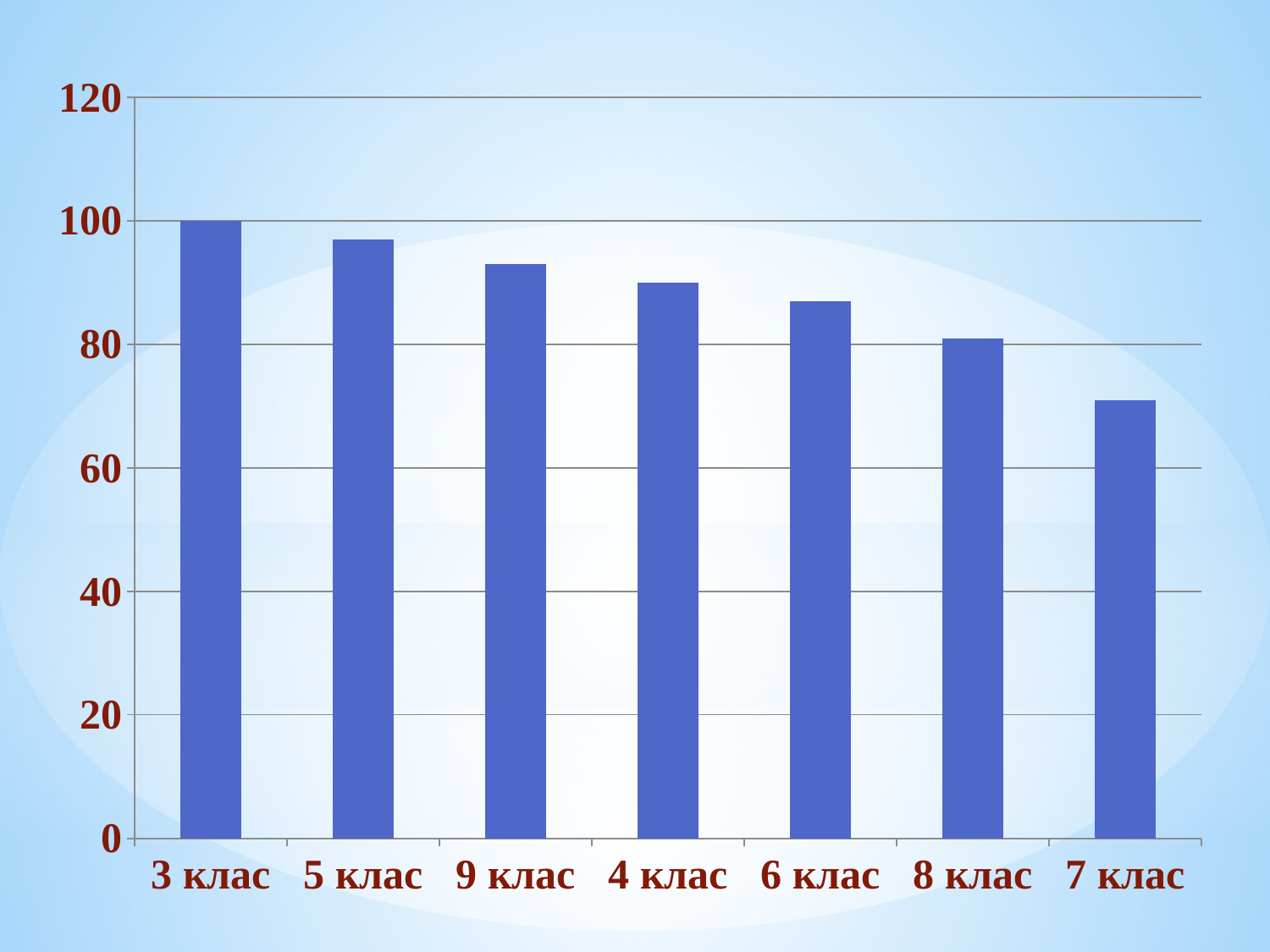
What is the value for 3 клас? 100 Which class has the highest bar? 3 клас Is the value for 5 клас greater or less than 80? greater Is the value for 8 клас greater or less than 100? less Which is larger, the value for 9 клас or the value for 8 клас? 9 клас Is the value for 7 клас greater or less than 80? less Which class has the lowest bar? 7 клас How many categories (classes) are shown on the x axis? 7 What kind of chart is shown on the slide? bar chart Do the bar values rise or fall from left to right along the x axis? fall What is the highest tick value shown on the vertical axis? 120